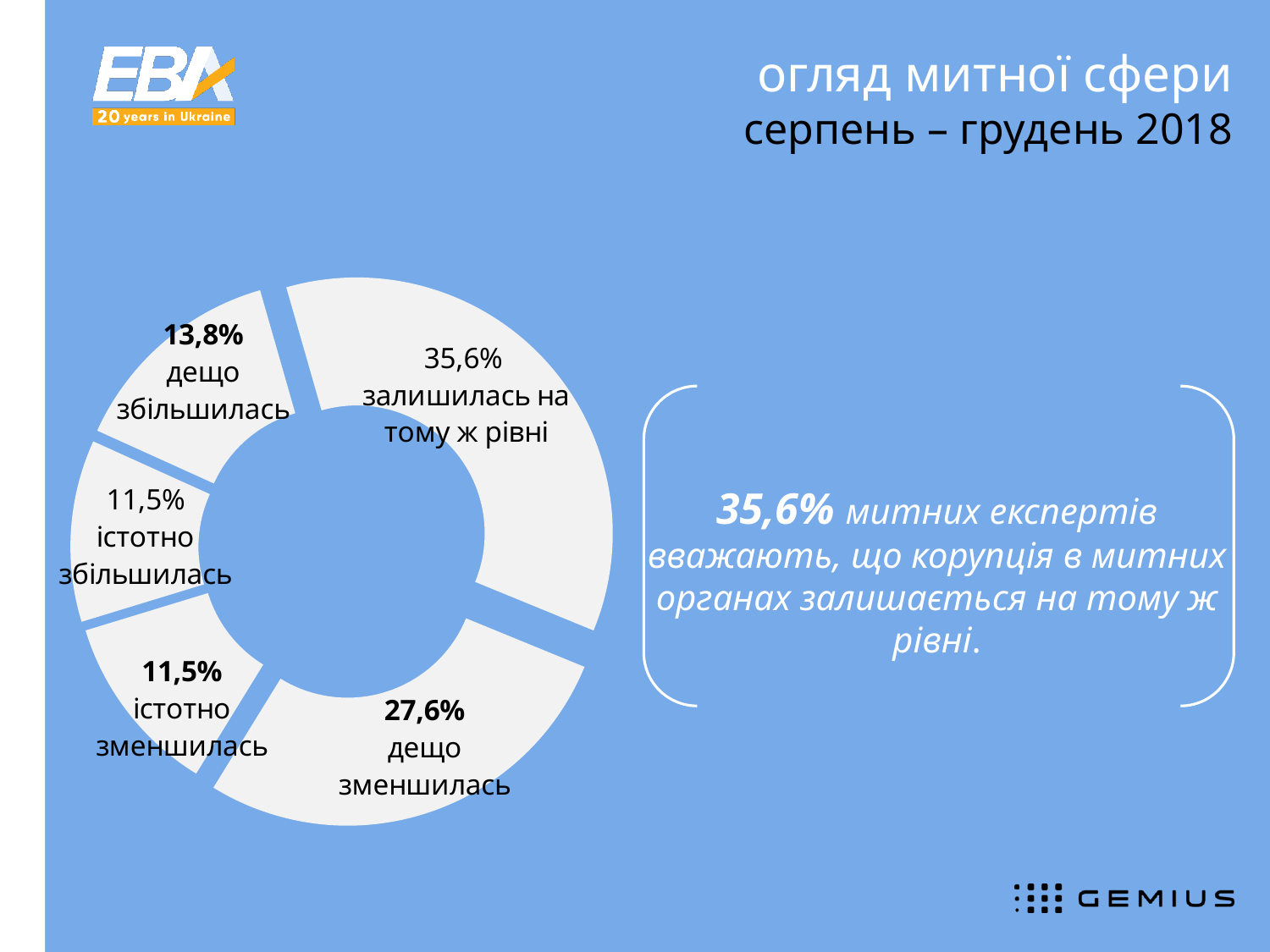
What is the combined share of "дещо зменшилась" and "істотно зменшилась"? 39,1% What share of respondents answered "залишилась на тому ж рівні"? 35,6% Which is larger: the share for "дещо збільшилась" or for "істотно зменшилась"? дещо збільшилась How many categories does the chart show? 5 What share of respondents answered "дещо зменшилась"? 27,6% Which category has the largest share in the chart? залишилась на тому ж рівні What is the smallest share shown in the chart? 11,5% What is the difference between the shares for "залишилась на тому ж рівні" and "дещо зменшилась"? 8,0% What share of respondents answered "дещо збільшилась"? 13,8% What kind of chart is shown on the slide? Donut (pie) chart What is the combined share of "дещо збільшилась" and "істотно збільшилась"? 25,3% What share of respondents answered "істотно збільшилась"? 11,5%